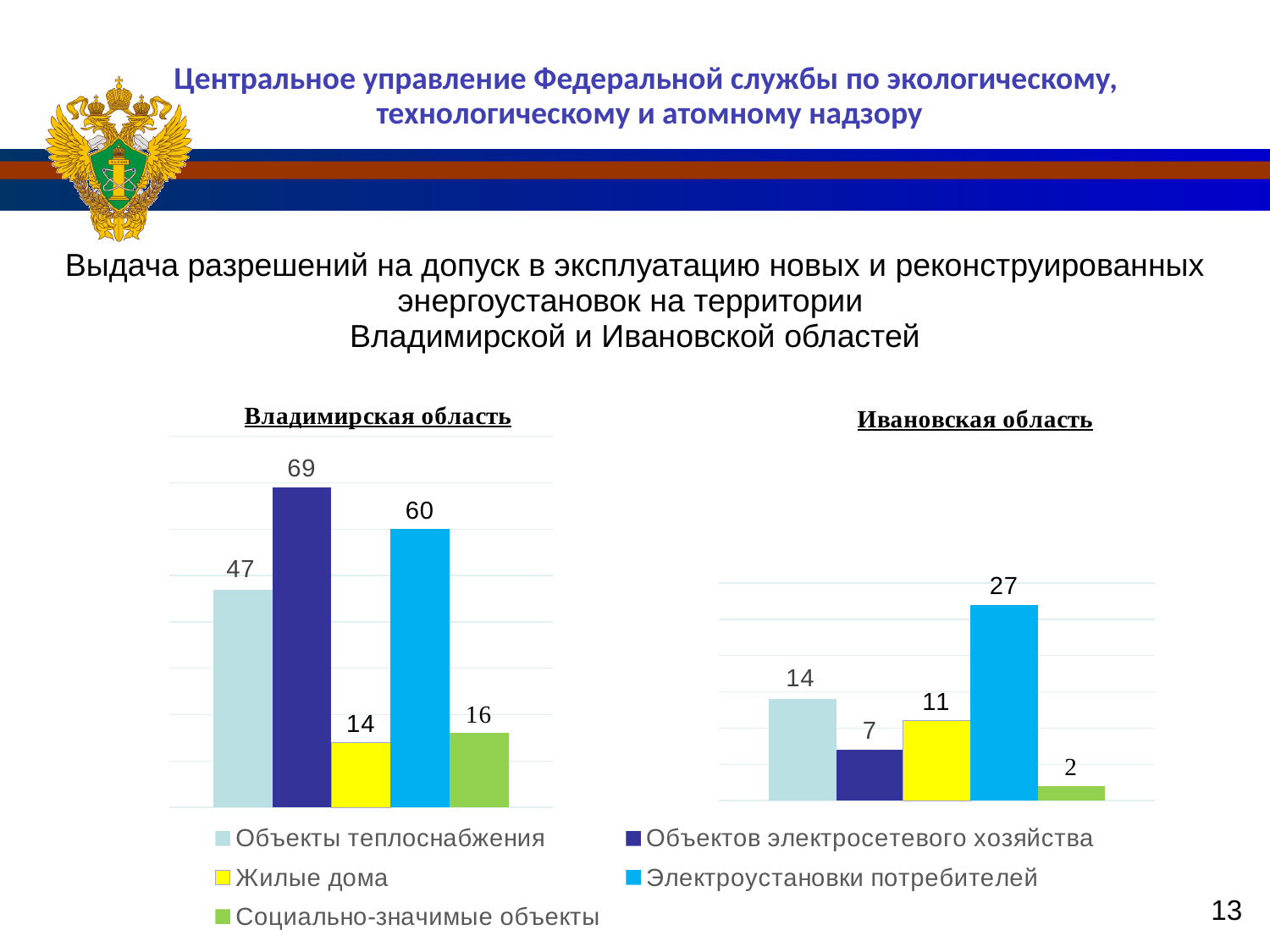
In the 'Ивановская область' chart, which category has the lowest value? Социально-значимые объекты How many series does the legend list? 5 In the 'Ивановская область' chart, which is larger: 'Жилые дома' or 'Объектов электросетевого хозяйства'? Жилые дома In the 'Ивановская область' chart, what is the value for 'Электроустановки потребителей'? 27 In the 'Владимирская область' chart, which category has the highest value? Объектов электросетевого хозяйства In the 'Ивановская область' chart, what is the difference between 'Объекты теплоснабжения' and 'Объектов электросетевого хозяйства'? 7 In the 'Владимирская область' chart, what is the value for 'Объектов электросетевого хозяйства'? 69 In the 'Владимирская область' chart, what is the difference between 'Объектов электросетевого хозяйства' and 'Электроустановки потребителей'? 9 In the 'Владимирская область' chart, what is the value for 'Жилые дома'? 14 In the 'Владимирская область' chart, what is the value for 'Социально-значимые объекты'? 16 What kind of chart is the 'Владимирская область' chart? Bar chart Which colour represents 'Электроустановки потребителей' in the legend? Light blue (cyan)